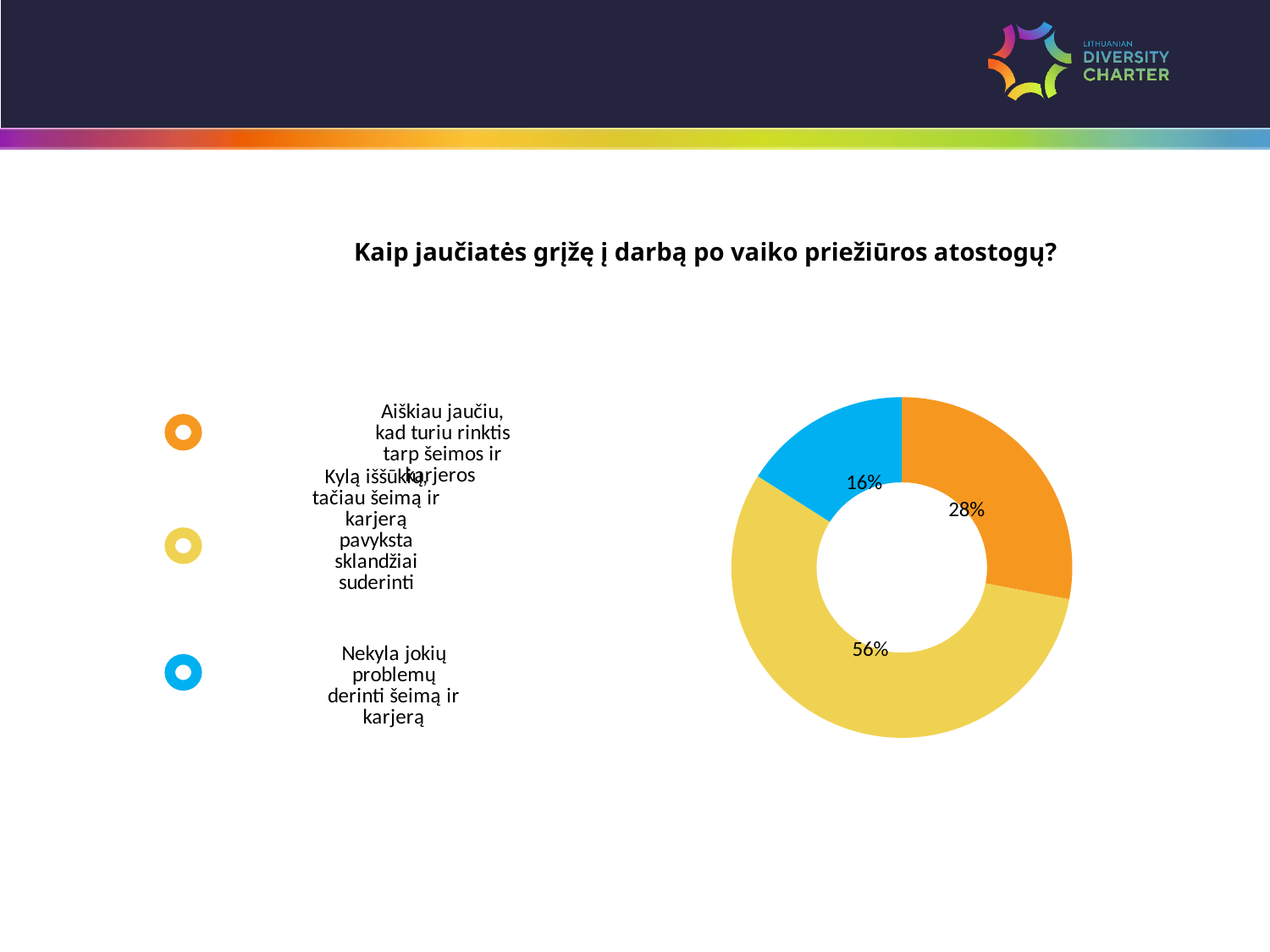
Which category has the smallest share of the doughnut chart? Nekyla jokių problemų derinti šeimą ir karjerą What percentage is shown for the blue slice, "Nekyla jokių problemų derinti šeimą ir karjerą"? 16% What colour is the slice labelled 16%? Blue Which is larger: the share for "Aiškiau jaučiu, kad turiu rinktis tarp šeimos ir karjeros" or the share for "Nekyla jokių problemų derinti šeimą ir karjerą"? Aiškiau jaučiu, kad turiu rinktis tarp šeimos ir karjeros What is the difference in percentage points between the orange slice (28%) and the blue slice (16%)? 12 What is the difference in percentage points between the yellow slice (56%) and the orange slice (28%)? 28 What percentage is shown for the yellow slice, "Kyla iššūkių, tačiau šeimą ir karjerą pavyksta sklandžiai suderinti"? 56% What is the title of the chart? Kaip jaučiatės grįžę į darbą po vaiko priežiūros atostogų? How many slices does the doughnut chart have? 3 What percentage is shown for the orange slice, "Aiškiau jaučiu, kad turiu rinktis tarp šeimos ir karjeros"? 28% What type of chart is shown on the slide? Doughnut chart Which category has the largest share of the doughnut chart? Kyla iššūkių, tačiau šeimą ir karjerą pavyksta sklandžiai suderinti